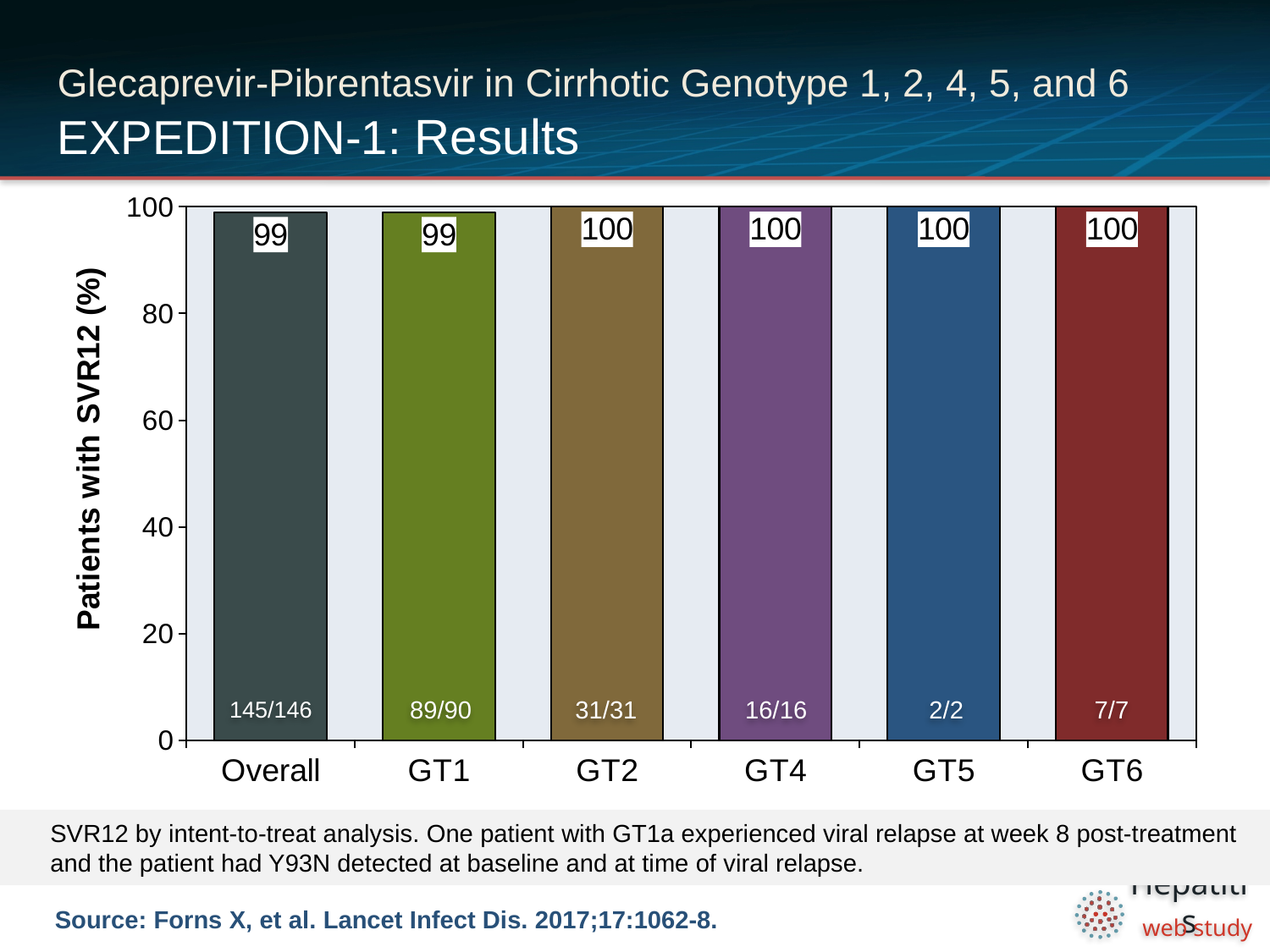
What is the SVR12 rate for the Overall group? 99 Which is larger, the SVR12 rate for GT6 or the SVR12 rate for Overall? GT6 What is the SVR12 rate for GT1? 99 What fraction of patients is shown inside the GT2 bar? 31/31 Is the SVR12 rate for GT1 greater or less than 80? greater How many categories are shown on the x axis? 6 What fraction of patients is shown inside the GT5 bar? 2/2 What is the difference between the SVR12 rate for GT2 and the SVR12 rate for GT1? 1 What is the SVR12 rate for GT4? 100 What kind of chart is shown on the slide? bar chart What is the label of the y axis? Patients with SVR12 (%) What fraction of patients is shown inside the Overall bar? 145/146